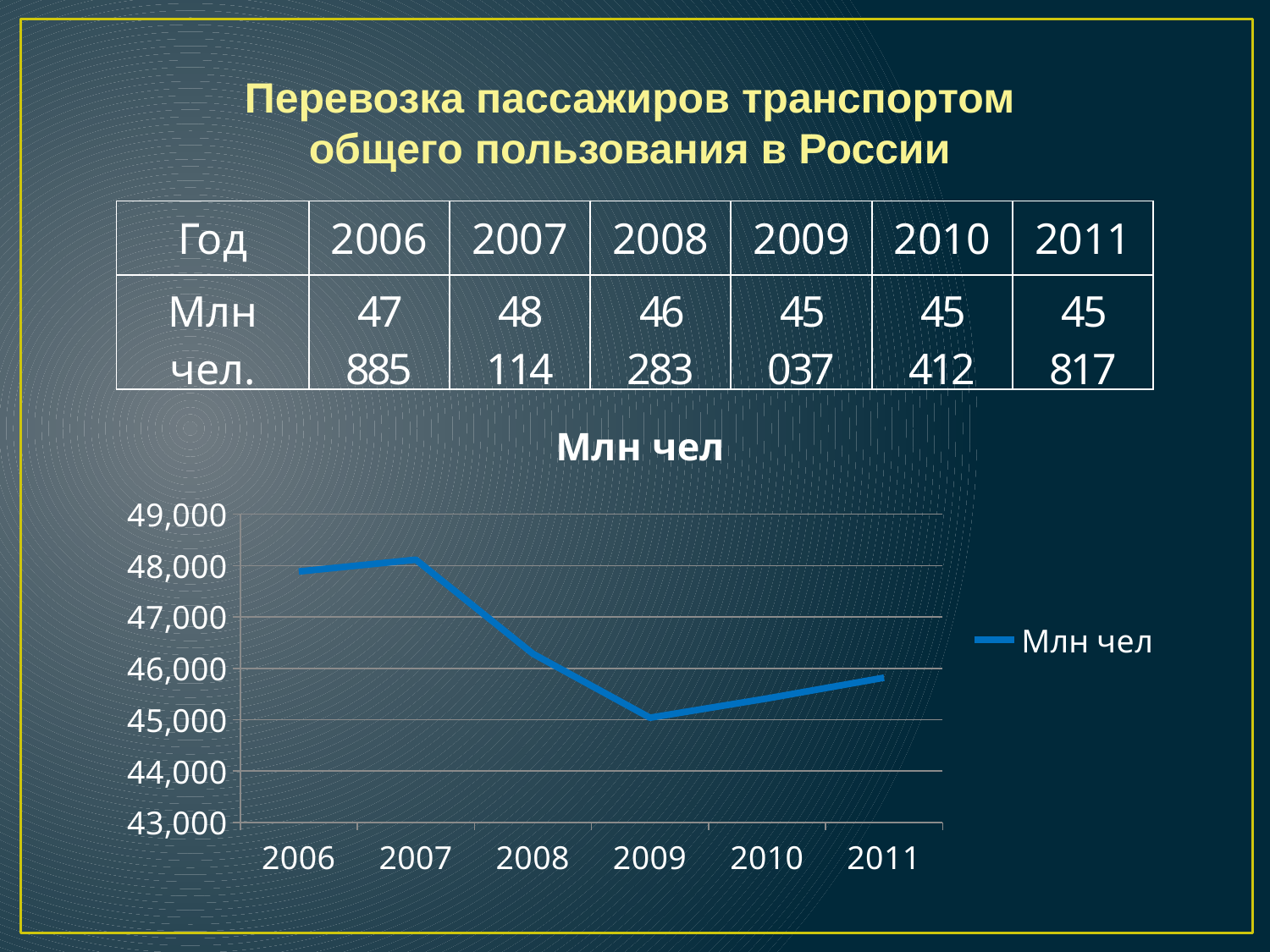
What kind of chart is shown on the slide? line chart Is the value for 2006 greater or less than 47,000? greater Does the line rise or fall from 2007 to 2009? fall How many years are plotted along the x axis of the chart? 6 Which year has the lowest value in the chart? 2009 According to the table on the slide, what is the value for 2009 (Млн чел.)? 45 037 Which is larger, the value for 2010 or the value for 2011? 2011 According to the table on the slide, what is the value for 2007 (Млн чел.)? 48 114 Is the value for 2008 greater or less than 47,000? less How many series does the chart legend list? 1 What is the title of the chart? Млн чел Which year has the highest value in the chart? 2007